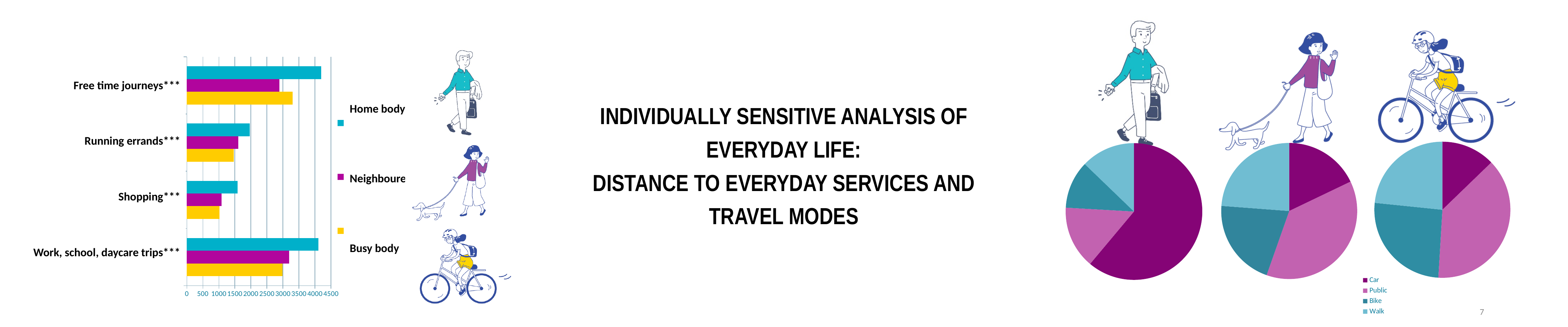
How many entries does the legend of the pie charts on the right list? 4 In the bar chart on the left, is the Neighboure value for Shopping*** greater or less than 1500? less In the bar chart on the left, for Free time journeys***, which is larger: Home body or Neighboure? Home body In the bar chart on the left, is the Home body value for Free time journeys*** greater or less than 4000? greater In the leftmost pie chart on the right side of the slide, which travel mode has the largest slice? Car How many categories does the bar chart on the left show? 4 In the bar chart on the left, is the Home body value for Running errands*** greater or less than 2500? less What kind of chart is the chart on the left of the slide? bar chart How many series does the legend of the bar chart on the left list? 3 In the bar chart on the left, which series has the highest value for Work, school, daycare trips***? Home body In the bar chart on the left, which category has the lowest Home body value? Shopping*** How many pie charts are shown on the right side of the slide? 3